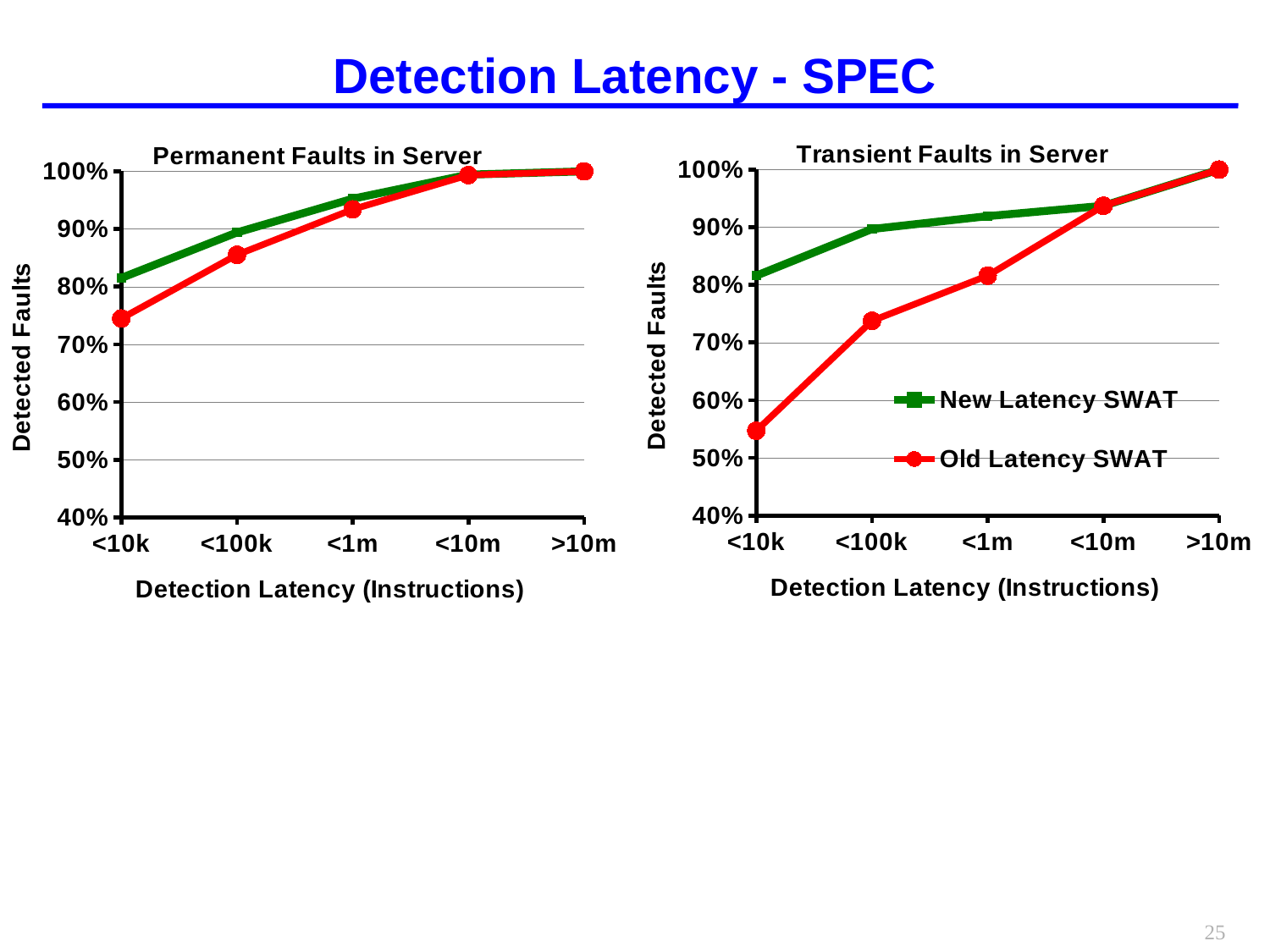
How many detection latency categories are shown on the x axis of the 'Transient Faults in Server' chart? 5 In the 'Transient Faults in Server' chart, which series has the higher value at <100k? New Latency SWAT In the 'Permanent Faults in Server' chart, what is the value for Old Latency SWAT at >10m? 100% What kind of chart is the 'Permanent Faults in Server' chart? line chart What is the title of the chart on the left of the slide? Permanent Faults in Server In the 'Transient Faults in Server' chart, do the Old Latency SWAT values rise or fall as detection latency increases along the x axis? rise In the 'Permanent Faults in Server' chart, is the value for Old Latency SWAT at <10k greater or less than 80%? less In the 'Transient Faults in Server' chart, is the value for Old Latency SWAT at <10k greater or less than 60%? less In the 'Transient Faults in Server' chart, at which detection latency is the Old Latency SWAT value lowest? <10k In the 'Permanent Faults in Server' chart, is the value for New Latency SWAT at <100k greater or less than 80%? greater What colour is the New Latency SWAT line in the charts? green How many series does the legend on the 'Transient Faults in Server' chart list? 2